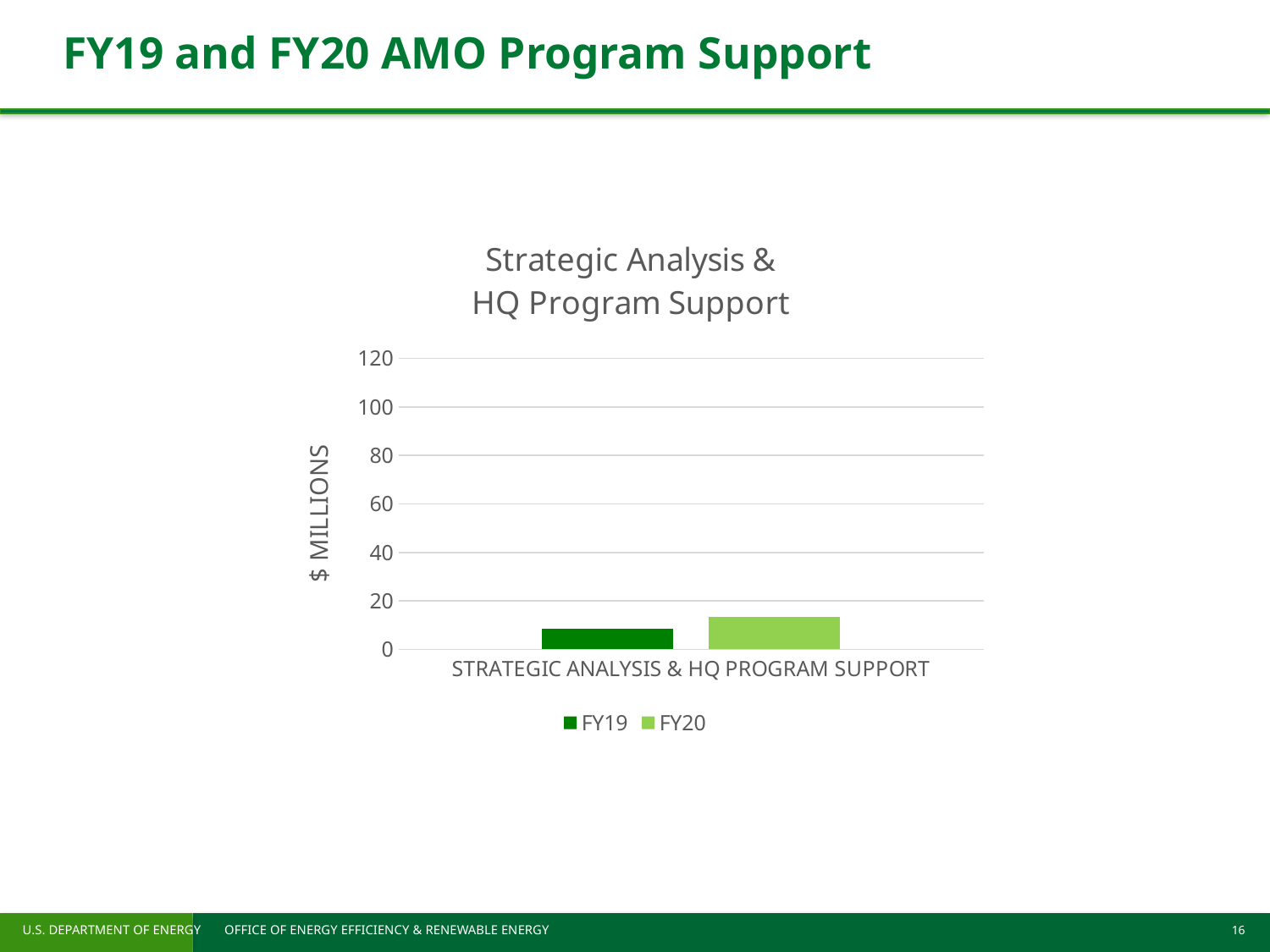
Is the FY20 value for Strategic Analysis & HQ Program Support greater or less than 40? less Is the FY19 value for Strategic Analysis & HQ Program Support greater or less than 20? less What kind of chart is shown on the slide? bar chart What is the highest value shown on the y axis? 120 Is the FY20 value for Strategic Analysis & HQ Program Support greater or less than 20? less What is the title of the chart? Strategic Analysis & HQ Program Support What is the label on the y axis of the chart? $ MILLIONS Which series has the larger value for Strategic Analysis & HQ Program Support, FY19 or FY20? FY20 How many series does the legend list? 2 How many categories are shown on the x axis? 1